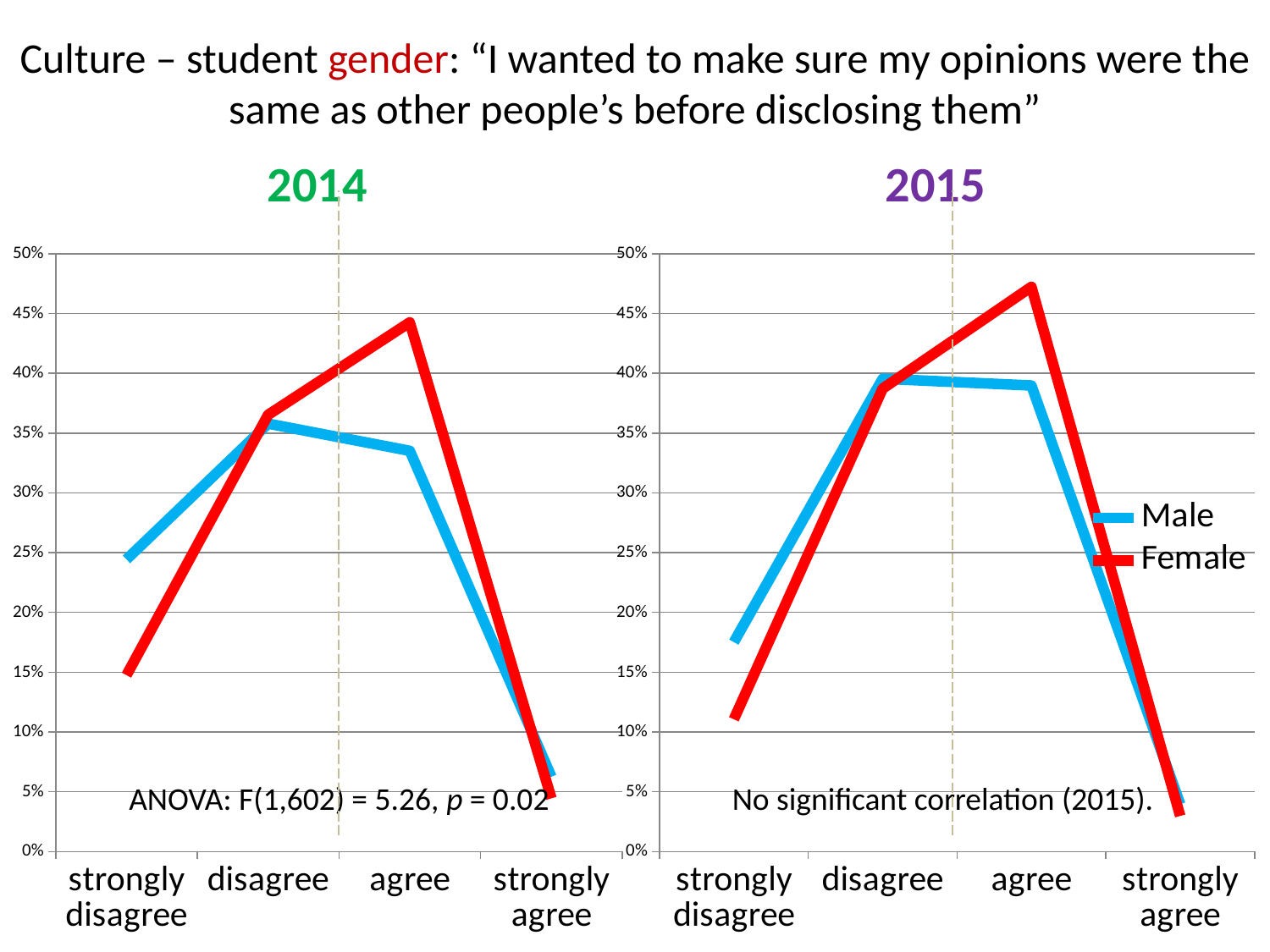
In the 2015 chart, which series has the higher value for 'agree', Male or Female? Female In the 2014 chart, at which category does the Female line reach its highest value? agree In the 2014 chart, which series has the higher value for 'strongly disagree', Male or Female? Male In the 2014 chart, is the Female value for 'agree' greater or less than 40%? greater How many series does the legend list? 2 What colour is the Female line in the charts? red In the 2015 chart, is the Male value for 'strongly disagree' greater or less than 20%? less In the 2015 chart, at which category does the Female line reach its highest value? agree In the 2014 chart, how many response categories are shown on the x axis? 4 In the 2014 chart, at which category is the Male line lowest? strongly agree In the 2015 chart, is the Female value for 'strongly disagree' greater or less than 15%? less What kind of chart is used for the 2014 and 2015 panels on this slide? line chart